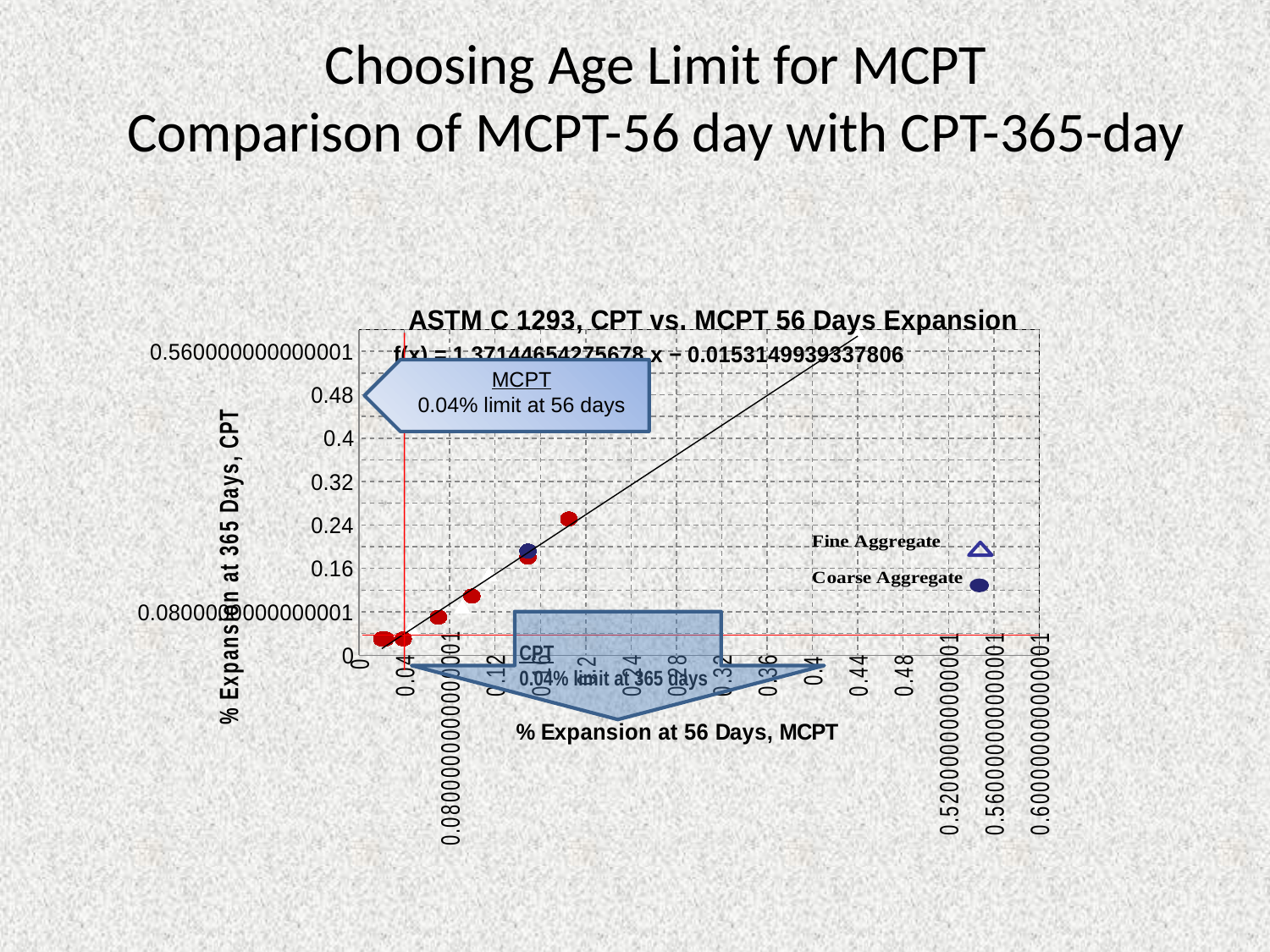
What is the title of the x axis of the chart? % Expansion at 56 Days, MCPT Is the highest plotted point's y value (% Expansion at 365 Days, CPT) greater or less than 0.32? less What kind of chart is shown on the slide? scatter chart How many series does the chart legend list? 2 Do the plotted CPT expansion values rise or fall as the MCPT expansion increases along the x axis? rise What is the title of the chart? ASTM C 1293, CPT vs. MCPT 56 Days Expansion Is the highest plotted point's x value (% Expansion at 56 Days, MCPT) greater or less than 0.24? less Is the highest plotted point's y value (% Expansion at 365 Days, CPT) greater or less than 0.16? greater